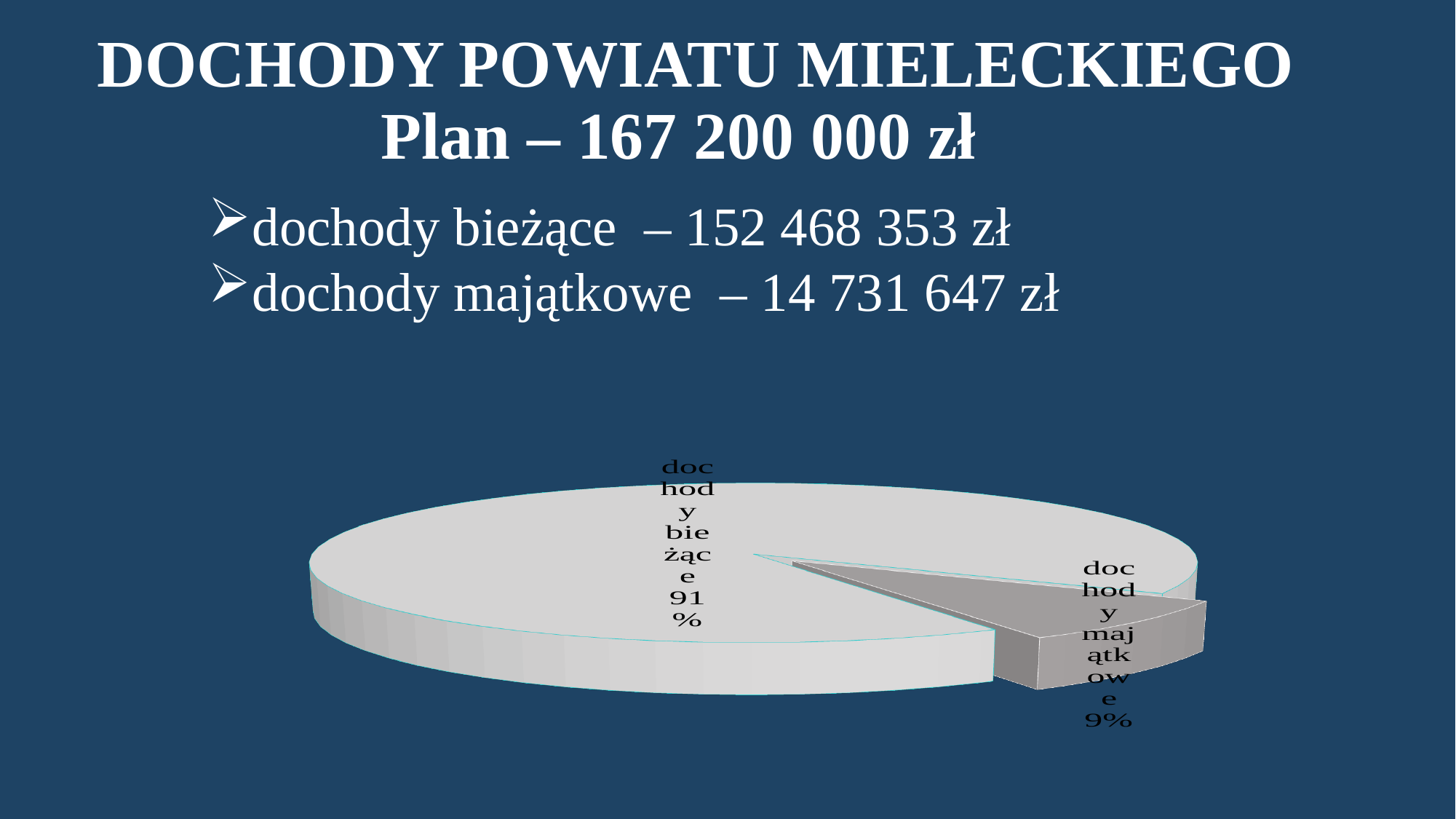
Which slice of the pie chart is the largest? dochody bieżące How many slices does the pie chart have? 2 Which slice of the pie chart is the smallest? dochody majątkowe What share of the pie does the slice "dochody bieżące" represent? 91% Which slice of the pie chart is exploded (pulled away from the rest of the pie)? dochody majątkowe What share of the pie does the slice "dochody majątkowe" represent? 9% What kind of chart is shown on the slide? pie chart By how many percentage points does the "dochody bieżące" share exceed the "dochody majątkowe" share? 82 Which slice is larger, "dochody bieżące" or "dochody majątkowe"? dochody bieżące What is the percentage label printed on the slice that is pulled out from the pie? 9% What is the total of the two percentage labels shown on the pie chart? 100%